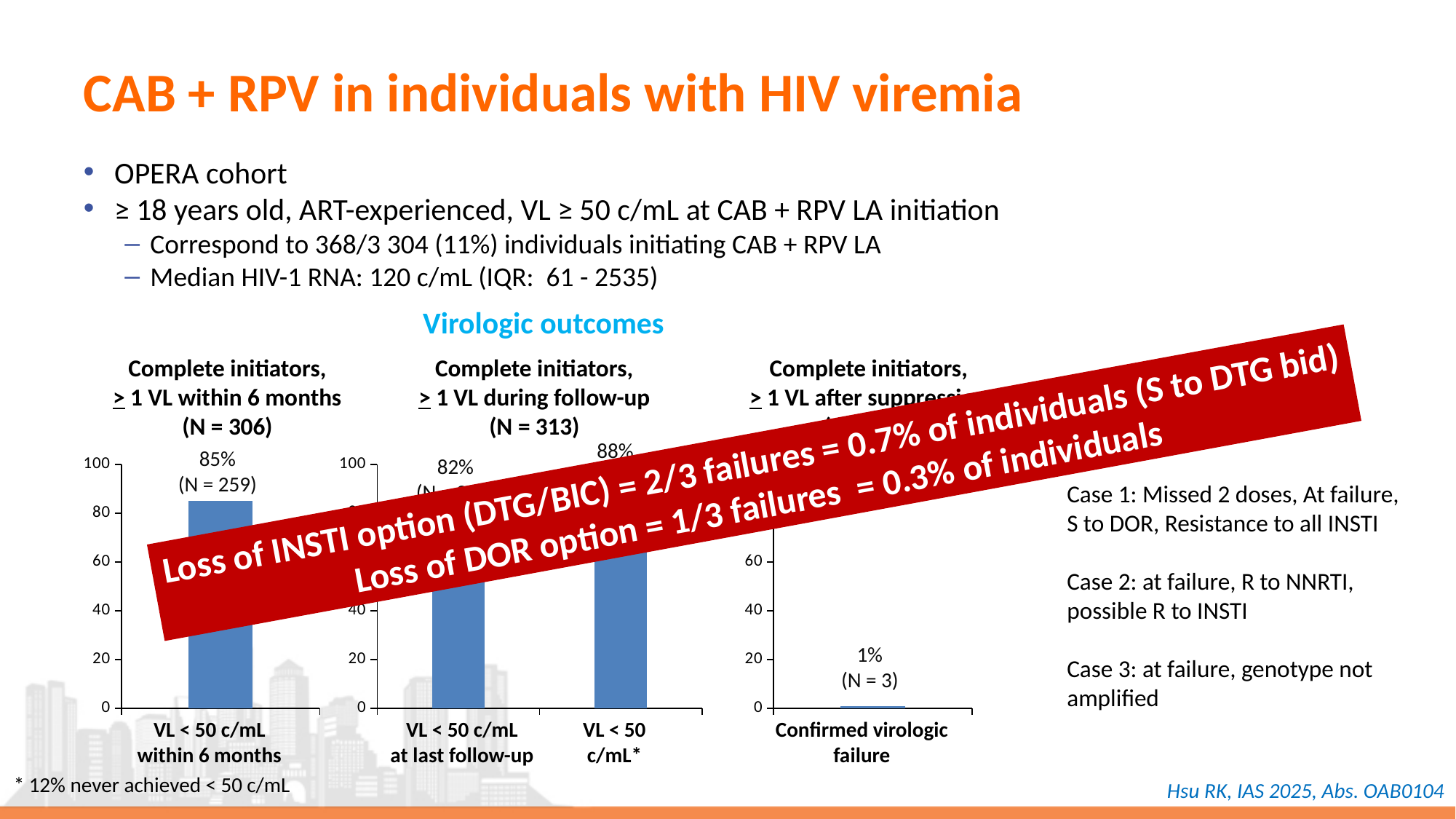
In the middle chart (Complete initiators, ≥ 1 VL during follow-up), what is the difference between the VL < 50 c/mL* bar and the VL < 50 c/mL at last follow-up bar? 6% In the right chart, what percentage of complete initiators had confirmed virologic failure? 1% In the left chart, is the value for VL < 50 c/mL within 6 months greater or less than 80? greater In the right chart, how many individuals (N) had confirmed virologic failure? N = 3 What type of chart is used for the virologic outcomes on this slide? Bar chart In the left chart (Complete initiators, ≥ 1 VL within 6 months), how many individuals (N) achieved VL < 50 c/mL within 6 months? N = 259 In the middle chart (Complete initiators, ≥ 1 VL during follow-up), which bar is higher: VL < 50 c/mL at last follow-up or VL < 50 c/mL*? VL < 50 c/mL* What is the N shown in the title of the middle chart (Complete initiators, ≥ 1 VL during follow-up)? N = 313 How many bars does the middle chart (Complete initiators, ≥ 1 VL during follow-up) have? 2 In the middle chart (Complete initiators, ≥ 1 VL during follow-up), what percentage had VL < 50 c/mL at last follow-up? 82% In the middle chart (Complete initiators, ≥ 1 VL during follow-up), what percentage is shown for the VL < 50 c/mL* bar? 88% In the left chart (Complete initiators, ≥ 1 VL within 6 months), what percentage achieved VL < 50 c/mL within 6 months? 85%